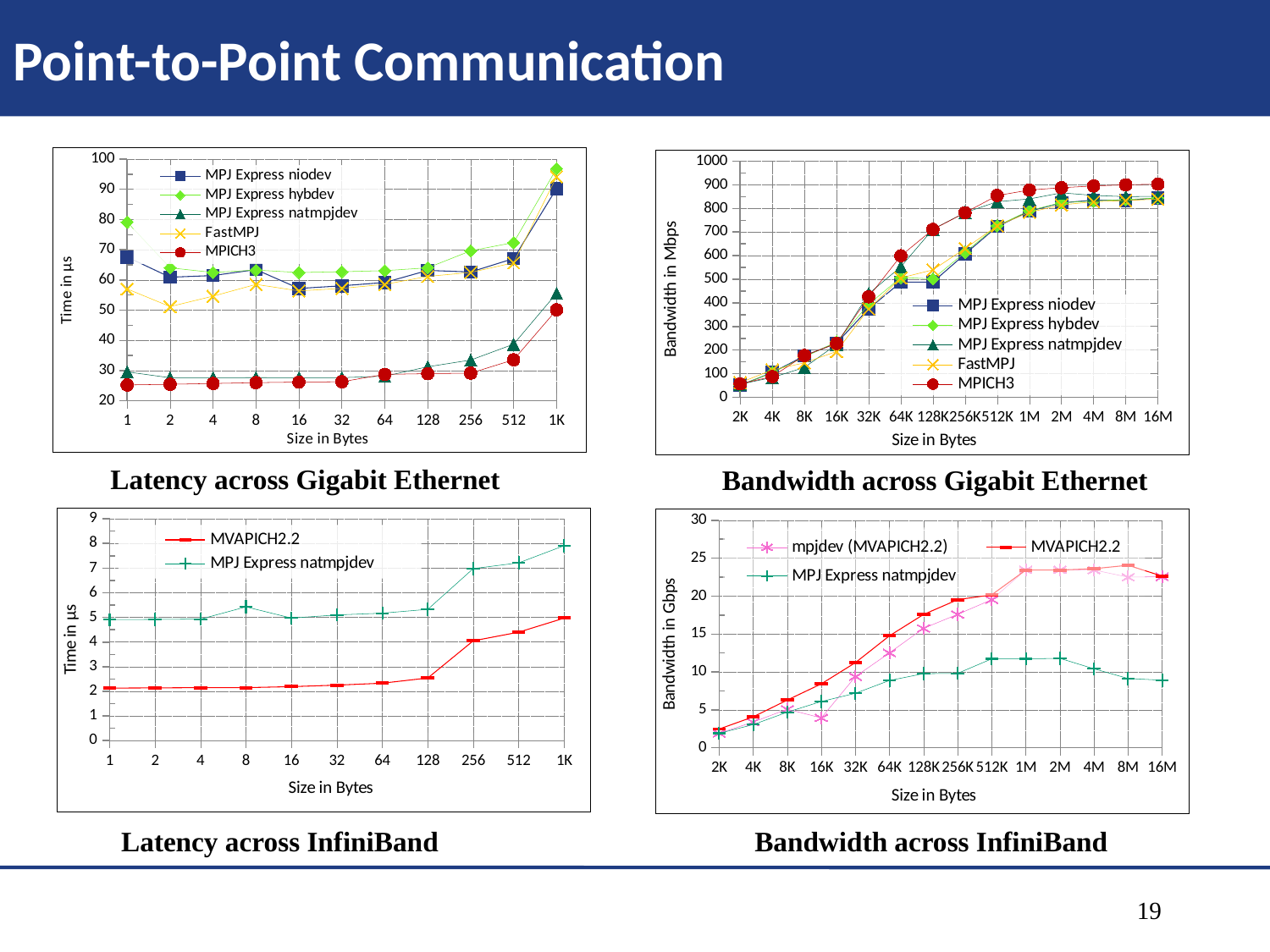
In the 'Bandwidth across Gigabit Ethernet' chart, is the value for MPICH3 at 16M greater or less than 800? greater In the 'Bandwidth across InfiniBand' chart, is the value for MPJ Express natmpjdev at 16M greater or less than 10? less In the 'Latency across InfiniBand' chart, how many series does the legend list? 2 In the 'Latency across Gigabit Ethernet' chart, is the value for MPICH3 at 1K greater or less than 60? less In the 'Latency across Gigabit Ethernet' chart, how many series does the legend list? 5 In the 'Bandwidth across Gigabit Ethernet' chart, do the values for MPJ Express niodev generally rise or fall as message size increases? rise In the 'Bandwidth across Gigabit Ethernet' chart, what kind of chart is used? line chart In the 'Latency across InfiniBand' chart, which series has the larger value at 256 bytes, MVAPICH2.2 or MPJ Express natmpjdev? MPJ Express natmpjdev In the 'Bandwidth across InfiniBand' chart, how many series does the legend list? 3 In the 'Bandwidth across Gigabit Ethernet' chart, how many message sizes are shown on the x axis? 14 In the 'Latency across Gigabit Ethernet' chart, how many message sizes are shown on the x axis? 11